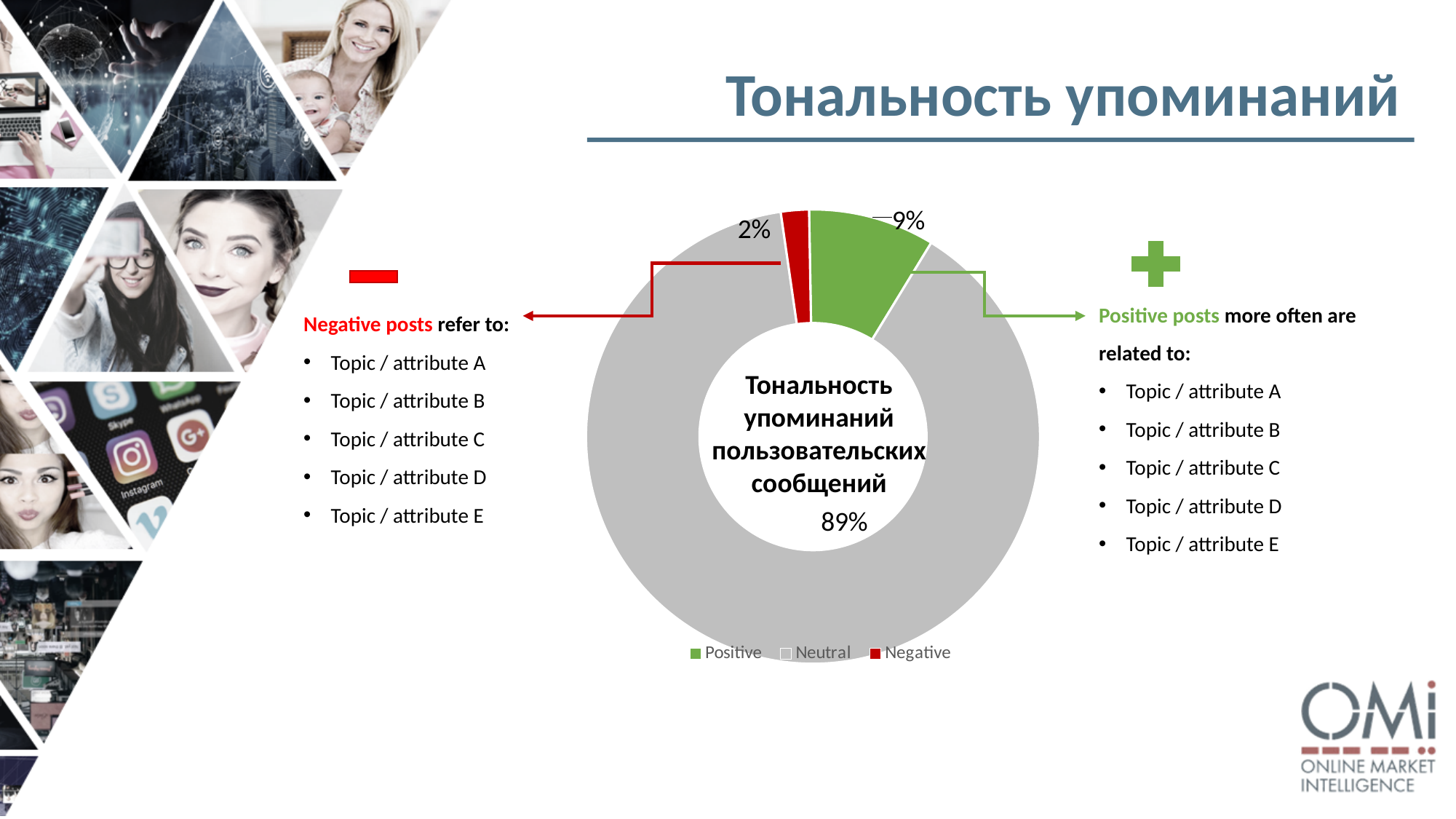
How many categories does the legend of the chart list? 3 What share of mentions is Neutral in the doughnut chart? 89% How many percentage points larger is the Neutral share than the Positive share? 80 What colour represents the Positive category in the chart? Green Which sentiment category has the smallest share in the chart? Negative What type of chart is shown on the slide? Doughnut chart How many percentage points larger is the Positive share than the Negative share? 7 Which is larger, the Positive share or the Negative share? Positive Which sentiment category has the largest share in the chart? Neutral What share of mentions is Positive in the doughnut chart? 9% What is the title written in the centre of the doughnut chart? Тональность упоминаний пользовательских сообщений What share of mentions is Negative in the doughnut chart? 2%